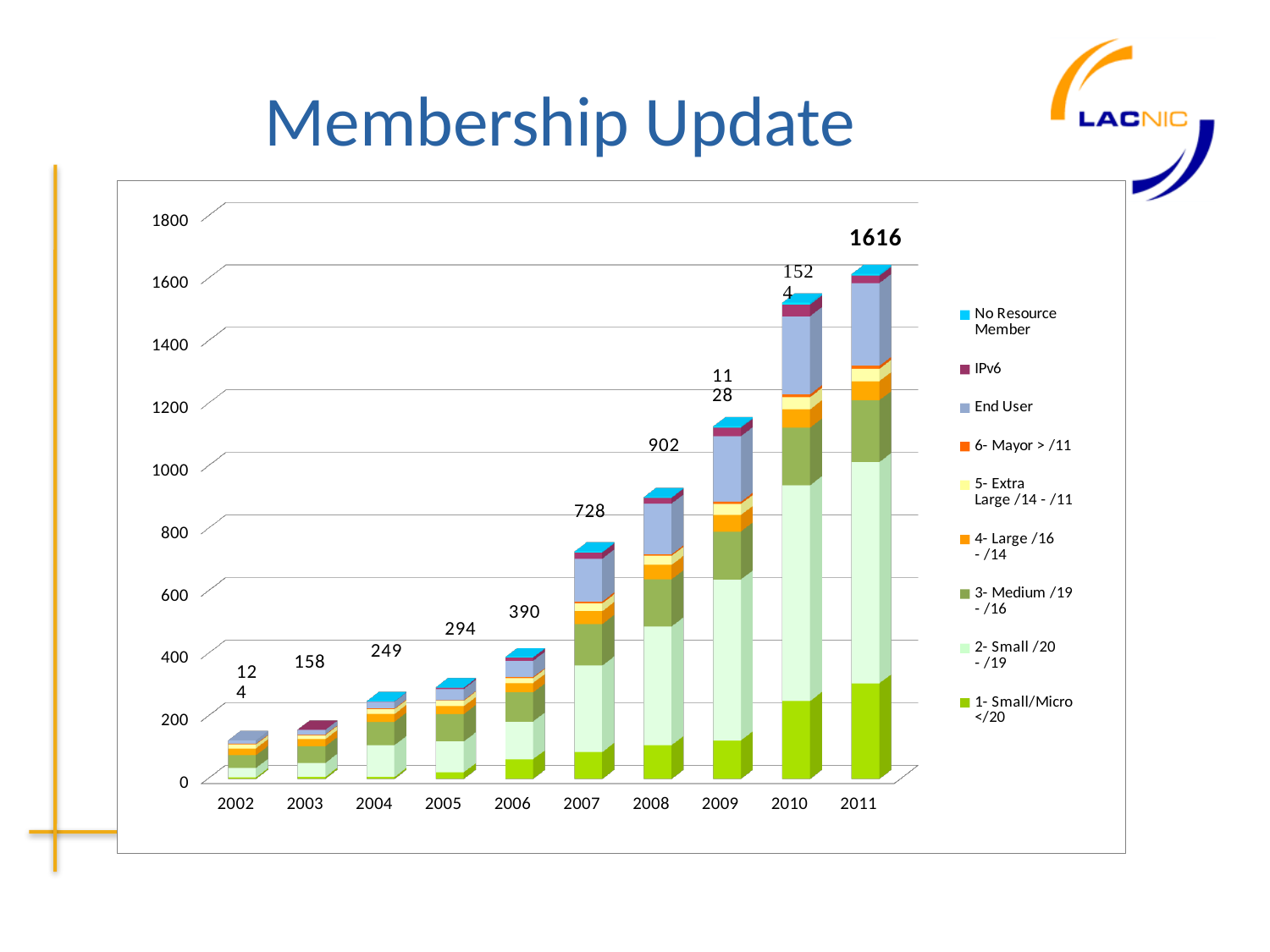
What is the total value labelled above the 2007 bar? 728 How many years are shown on the x axis of the chart? 10 Do the total membership values rise or fall from 2002 to 2011? Rise What is the difference between the 2008 total (902) and the 2007 total (728)? 174 Which year has the highest total membership? 2011 Is the total for 2009 greater or less than 1000? greater Which year has the larger total, 2005 or 2006? 2006 What is the total membership value labelled for 2011? 1616 What is the total value labelled above the 2008 bar? 902 How many series does the chart's legend list? 9 What kind of chart is shown on the slide? Stacked bar chart Which year has the lowest total membership? 2002